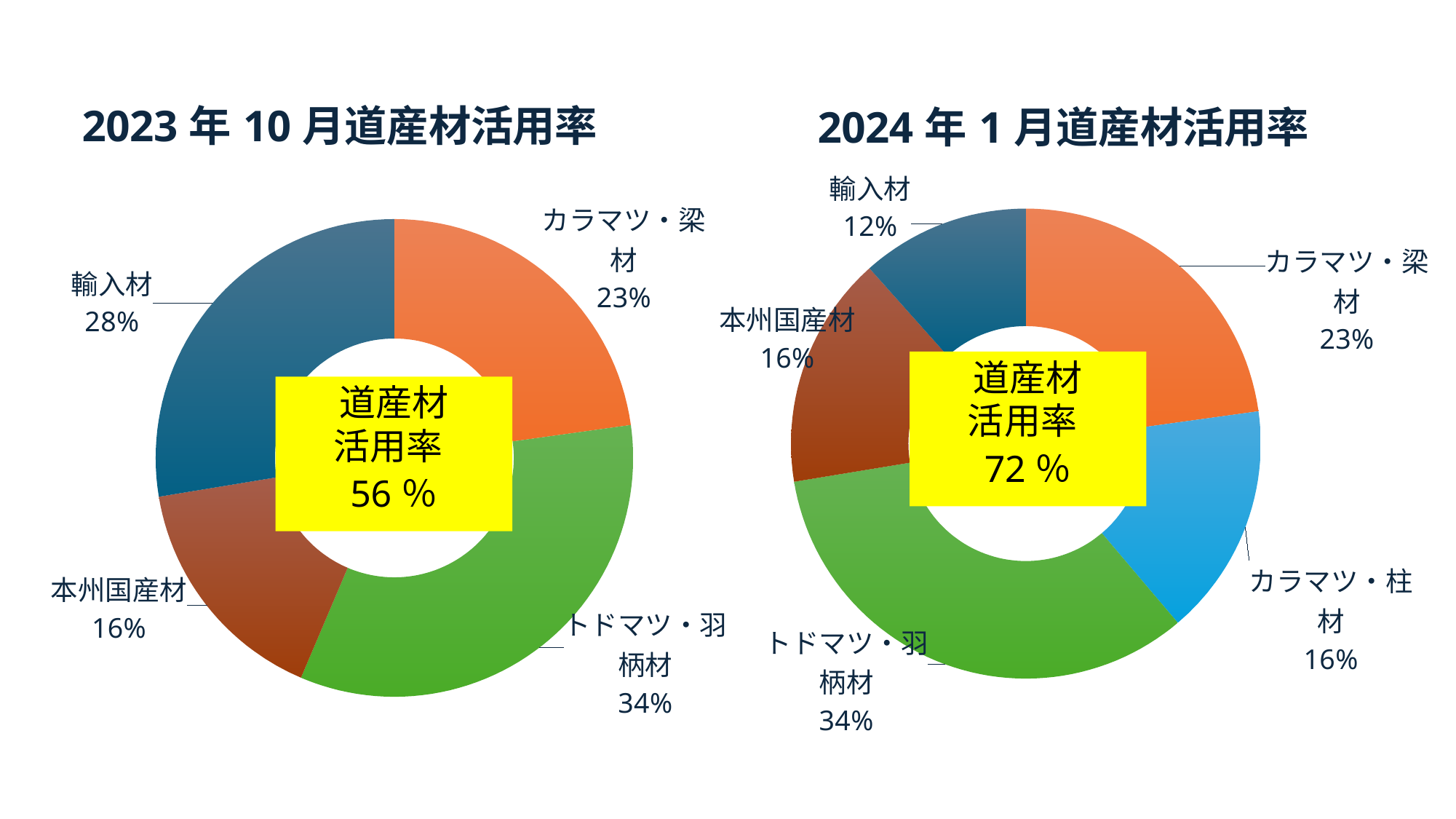
In the 2023年10月道産材活用率 chart, which category has the smallest share? 本州国産材 In the 2024年1月道産材活用率 chart, what is the share for カラマツ・柱材? 16% In the 2024年1月道産材活用率 chart, what is the difference between the shares of トドマツ・羽柄材 and カラマツ・梁材? 11 percentage points What type of chart is the 2023年10月道産材活用率 chart? Doughnut (pie) chart In the 2023年10月道産材活用率 chart, what is the share for トドマツ・羽柄材? 34% What 道産材活用率 value is shown in the centre of the 2024年1月 chart? 72 % In the 2024年1月道産材活用率 chart, which category has the smallest share? 輸入材 In the 2023年10月道産材活用率 chart, what is the share for 輸入材? 28% How many categories are shown in the 2024年1月道産材活用率 chart? 5 In the 2023年10月道産材活用率 chart, which category has the largest share? トドマツ・羽柄材 Comparing the two charts, is the share of 輸入材 larger in the 2023年10月 chart or the 2024年1月 chart? 2023年10月 In the 2024年1月道産材活用率 chart, what is the share for 輸入材? 12%